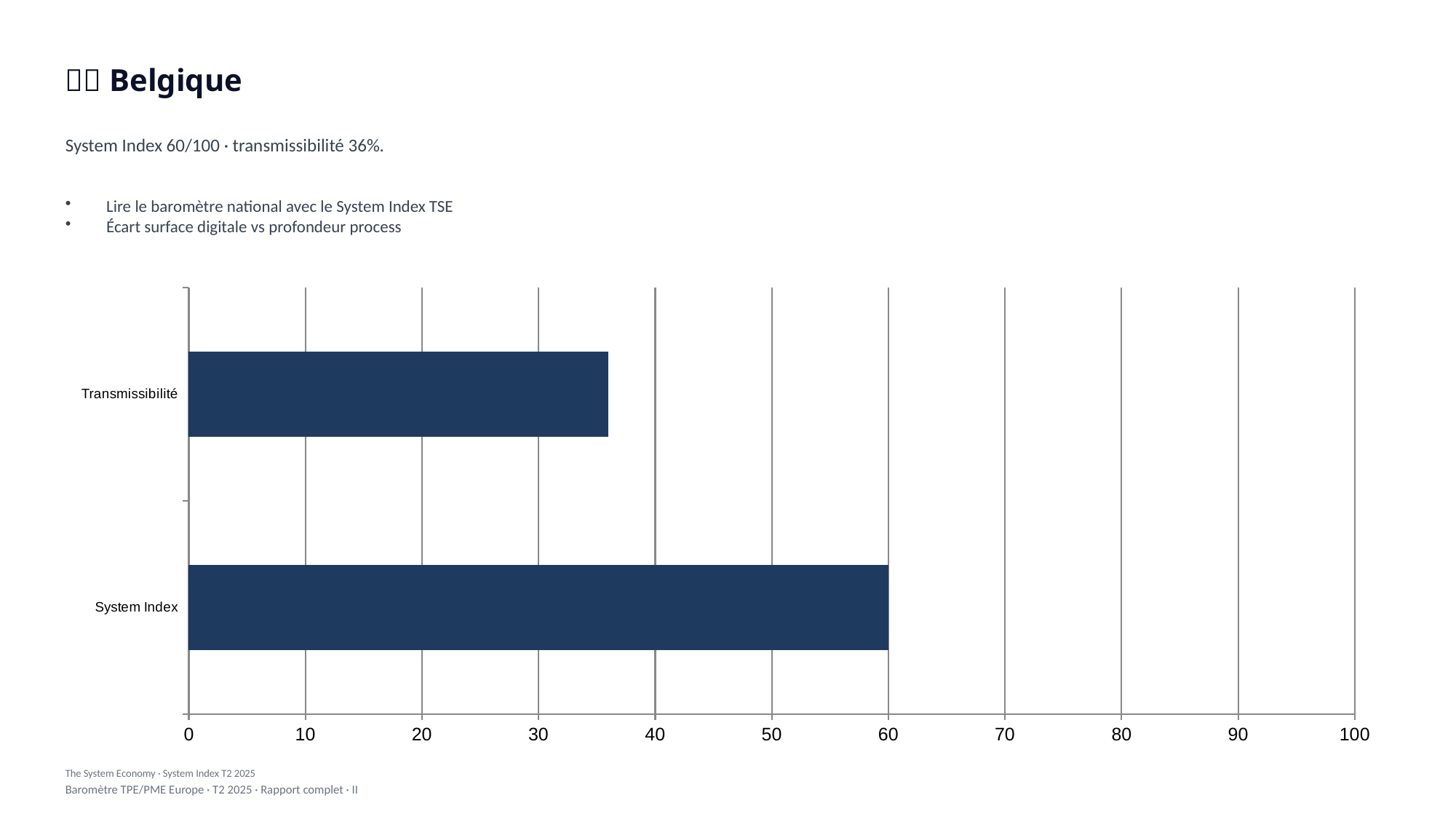
Which is larger, the value for System Index or the value for Transmissibilité? System Index What is the title of the slide containing the chart? Belgique Is the value for System Index greater or less than 50? greater How many categories does the chart show? 2 Is the value for Transmissibilité greater or less than 40? less What is the value for System Index in the chart? 60 What is the maximum value shown on the x axis of the chart? 100 Which category has the highest value in the chart? System Index Is the value for Transmissibilité greater or less than 30? greater Which category has the lowest value in the chart? Transmissibilité What type of chart is shown on the slide? bar chart